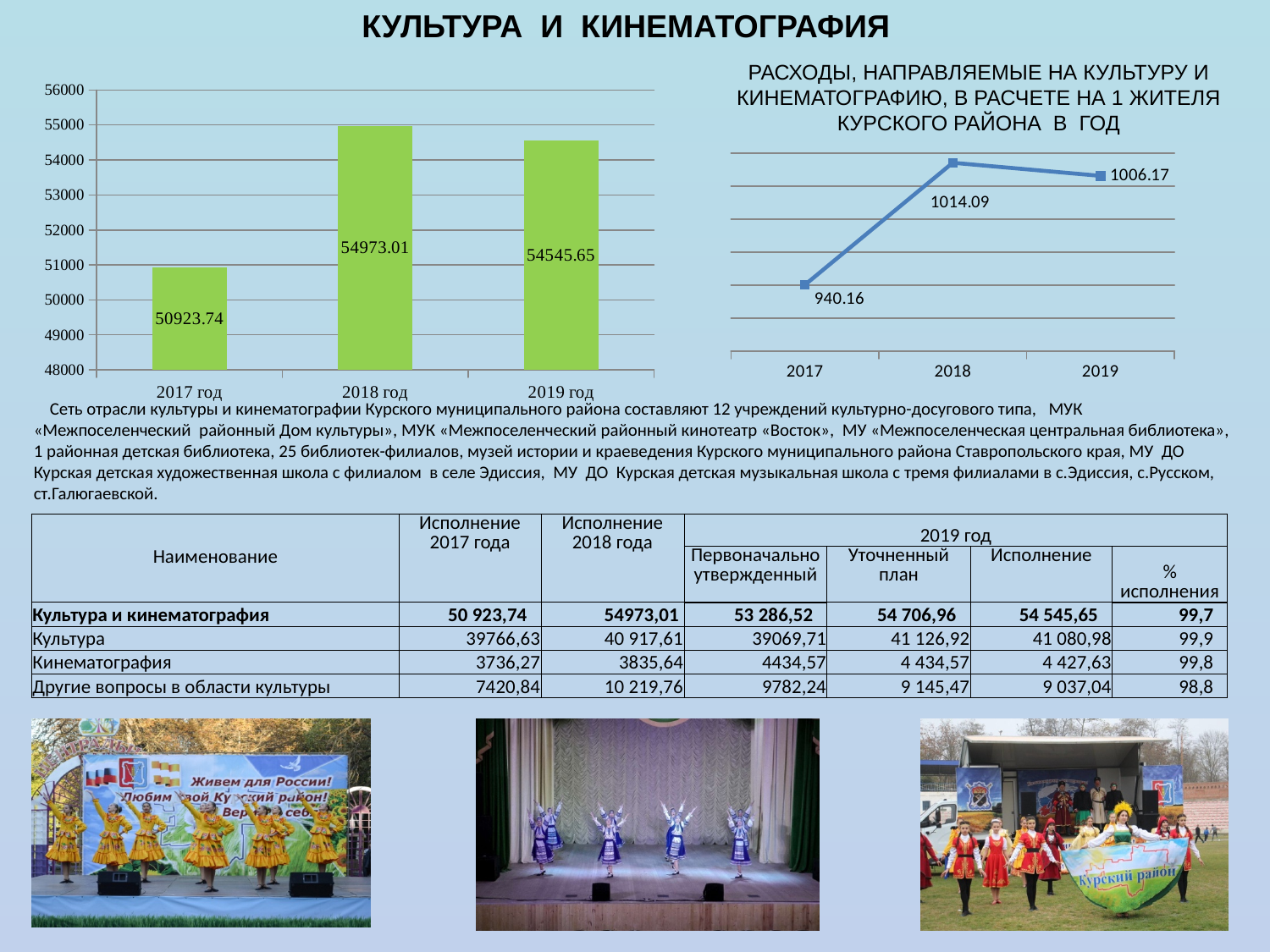
What kind of chart is the chart on the right of the slide? line chart In the bar chart on the left, which year has the highest value? 2018 год In the line chart titled 'РАСХОДЫ, НАПРАВЛЯЕМЫЕ НА КУЛЬТУРУ И КИНЕМАТОГРАФИЮ, В РАСЧЕТЕ НА 1 ЖИТЕЛЯ КУРСКОГО РАЙОНА В ГОД', which year has the highest value? 2018 In the bar chart on the left, what is the value for 2018 год? 54973.01 In the bar chart on the left, which year has the lowest value? 2017 год In the bar chart on the left, what is the difference between the 2018 год and 2017 год values? 4049.27 In the bar chart on the left, how many bars are plotted? 3 In the line chart titled 'РАСХОДЫ, НАПРАВЛЯЕМЫЕ НА КУЛЬТУРУ И КИНЕМАТОГРАФИЮ, В РАСЧЕТЕ НА 1 ЖИТЕЛЯ КУРСКОГО РАЙОНА В ГОД', what is the value for 2017? 940.16 In the line chart titled 'РАСХОДЫ, НАПРАВЛЯЕМЫЕ НА КУЛЬТУРУ И КИНЕМАТОГРАФИЮ, В РАСЧЕТЕ НА 1 ЖИТЕЛЯ КУРСКОГО РАЙОНА В ГОД', what is the difference between the 2018 and 2017 values? 73.93 In the line chart titled 'РАСХОДЫ, НАПРАВЛЯЕМЫЕ НА КУЛЬТУРУ И КИНЕМАТОГРАФИЮ, В РАСЧЕТЕ НА 1 ЖИТЕЛЯ КУРСКОГО РАЙОНА В ГОД', what is the value for 2019? 1006.17 In the bar chart on the left, what is the value for 2017 год? 50923.74 What kind of chart is the chart on the left of the slide? bar chart